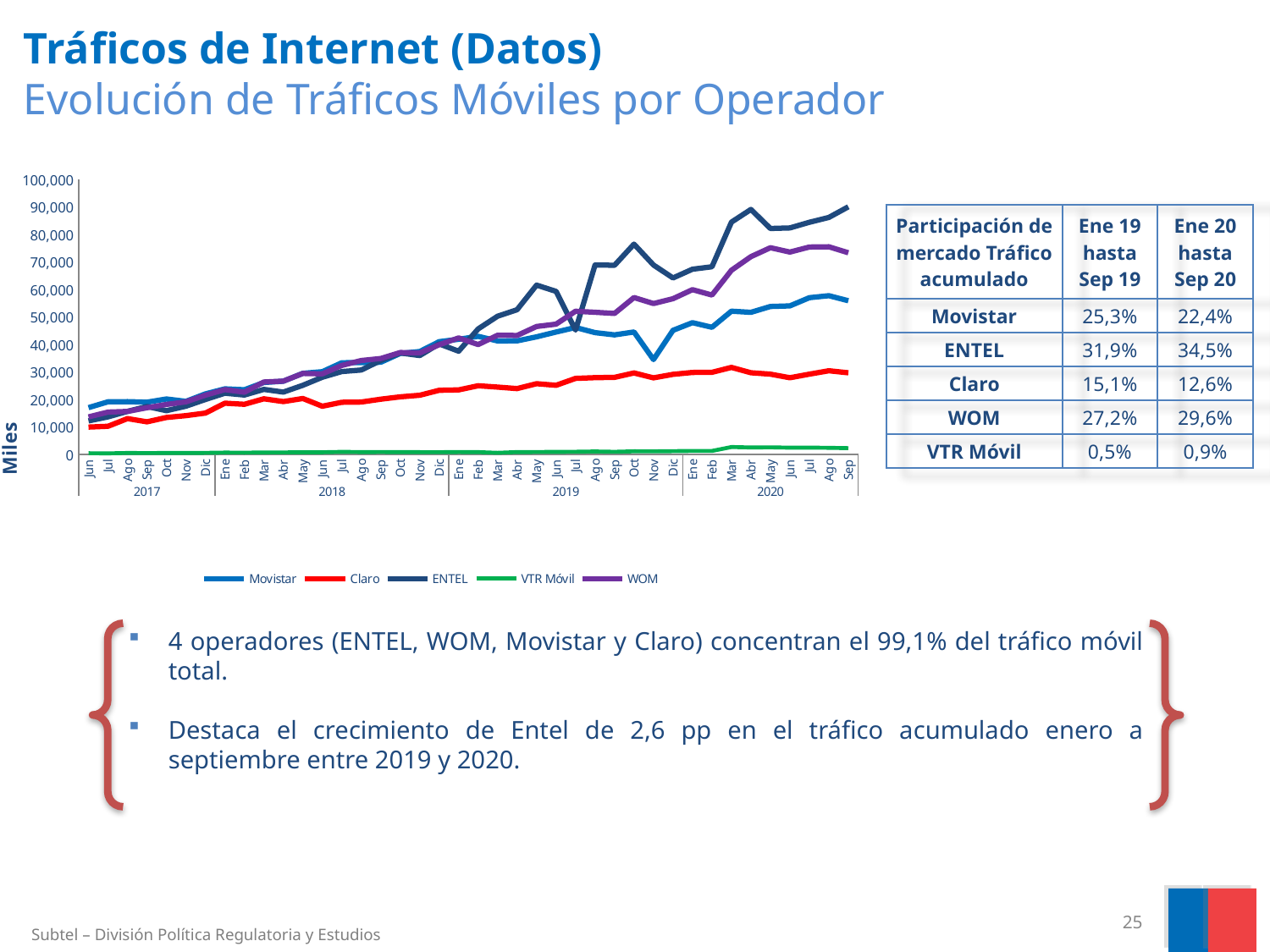
What kind of chart is shown on the slide? Line chart Is the value for WOM in Sep 2020 greater or less than 70,000? greater Is the value for ENTEL in Sep 2020 greater or less than 80,000? greater What is the label on the vertical axis of the chart? Miles In Sep 2020, which is larger, the traffic for WOM or for Claro? WOM Which operator has the highest mobile traffic at the end of the chart (Sep 2020)? ENTEL Does the ENTEL line generally rise or fall from Jun 2017 to Sep 2020? Rise What colour is the Claro line in the chart? Red How many series does the chart's legend list? 5 Which operator has the lowest mobile traffic throughout the chart? VTR Móvil Is the value for VTR Móvil in Sep 2020 greater or less than 10,000? less